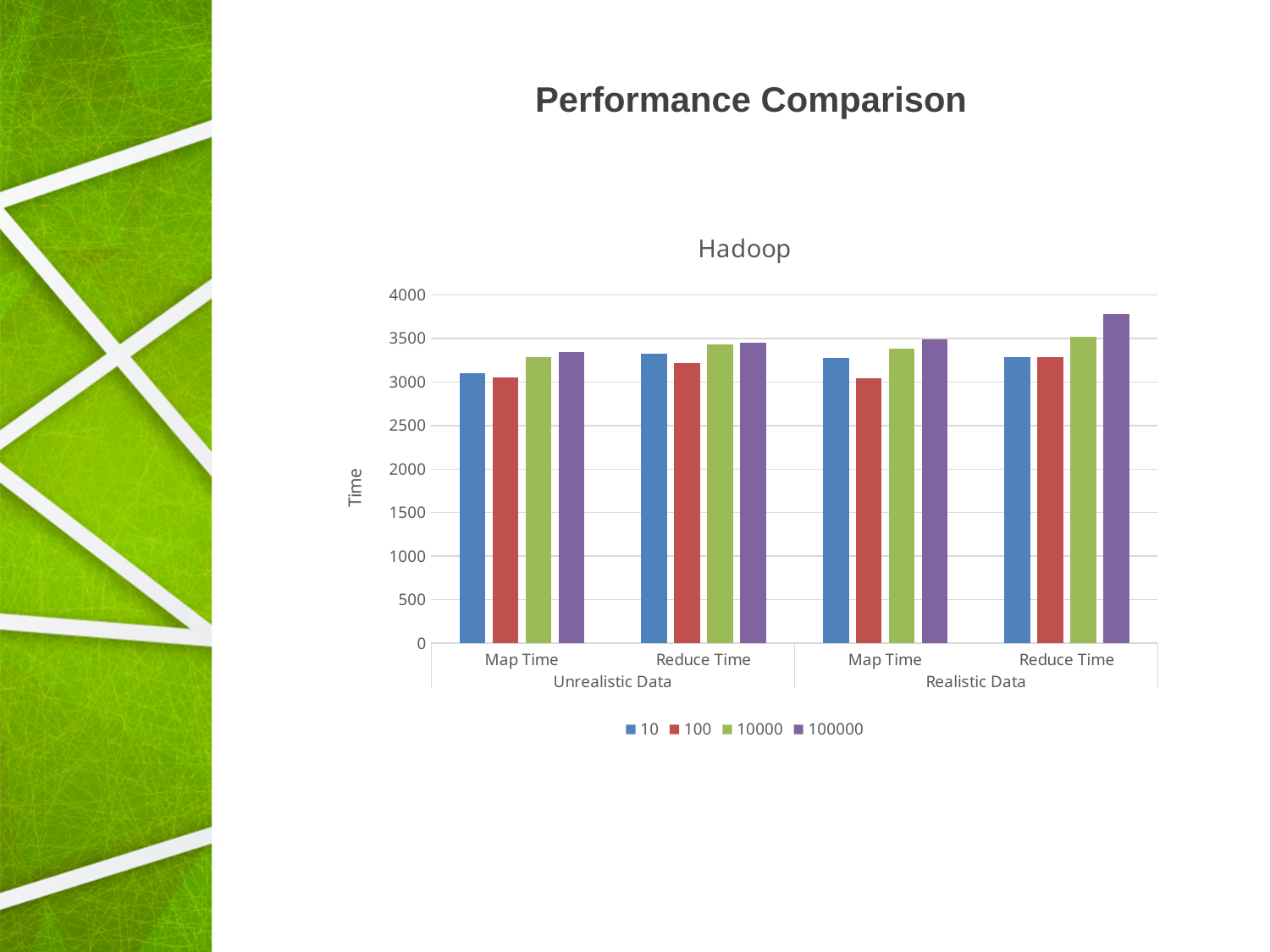
Is the value for the 100000 series at Reduce Time under Realistic Data greater or less than 3500? greater How many series does the legend of the Hadoop chart list? 4 Which series has the shortest bar at Map Time under Realistic Data? 100 What is the title of the chart? Hadoop Is the value for the 10 series at Map Time under Unrealistic Data greater or less than 3000? greater Which series has the tallest bar at Reduce Time under Realistic Data? 100000 At Map Time under Unrealistic Data, which is larger: the value for the 100 series or the value for the 100000 series? 100000 How many category groups of bars are plotted along the x axis of the Hadoop chart? 4 What kind of chart is shown on the slide? bar chart Is the value for the 100 series at Map Time under Realistic Data greater or less than 3500? less What are the series names listed in the legend of the Hadoop chart? 10, 100, 10000, 100000 Which category and series combination has the highest bar in the whole Hadoop chart? 100000 at Reduce Time under Realistic Data